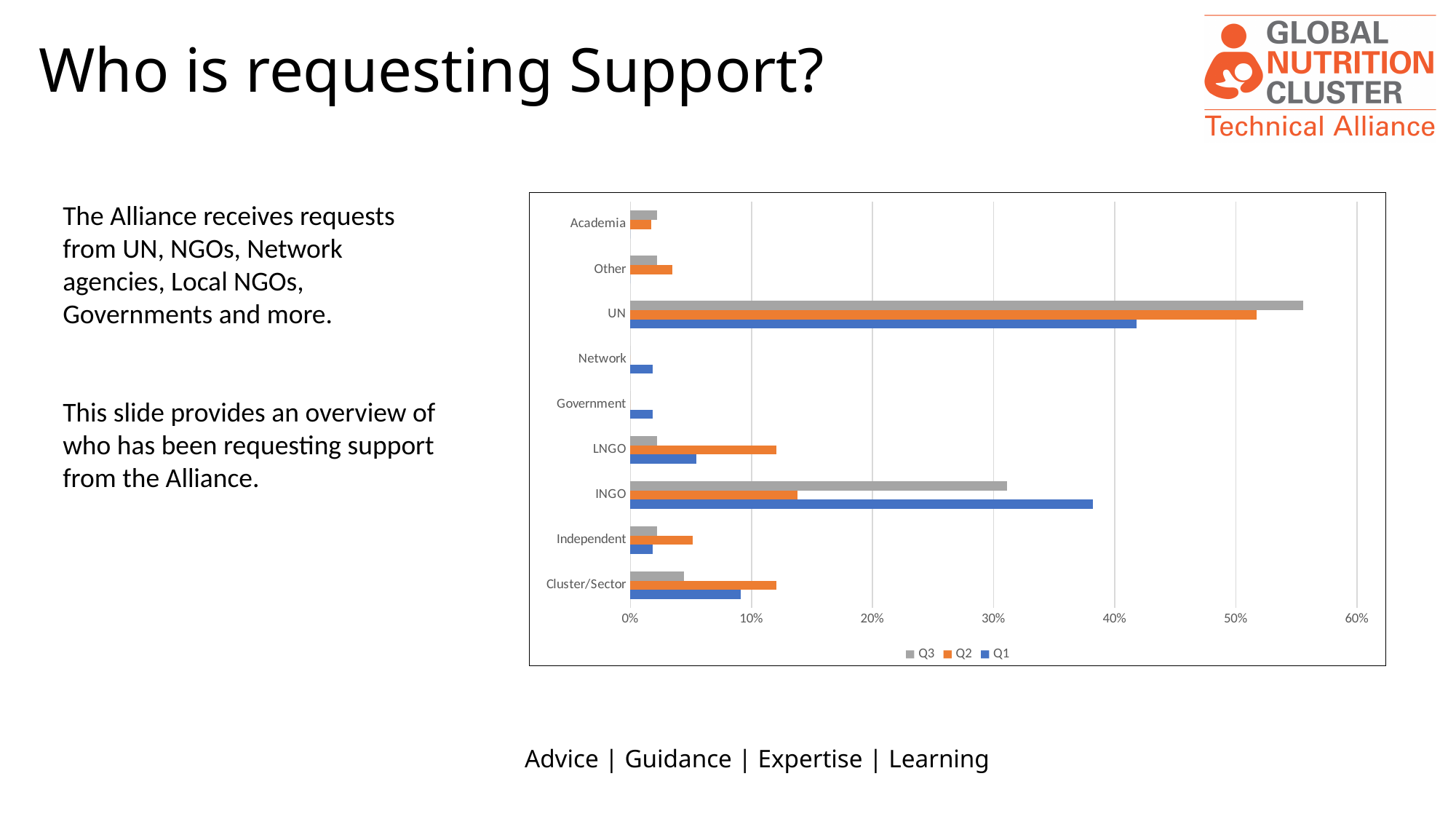
What kind of chart is shown on the slide? bar chart How many series does the chart's legend list? 3 What colour represents the Q2 series in the chart? orange For INGO, which series has the larger value, Q1 or Q2? Q1 Which category has the longest Q3 bar? UN For UN, which series has the larger value, Q3 or Q1? Q3 Is the Q2 value for LNGO greater or less than 10%? greater Is the Q3 value for UN greater or less than 50%? greater Is the Q3 value for INGO greater or less than 30%? greater Which category has the longest Q1 bar? UN How many categories are listed on the vertical axis of the chart? 9